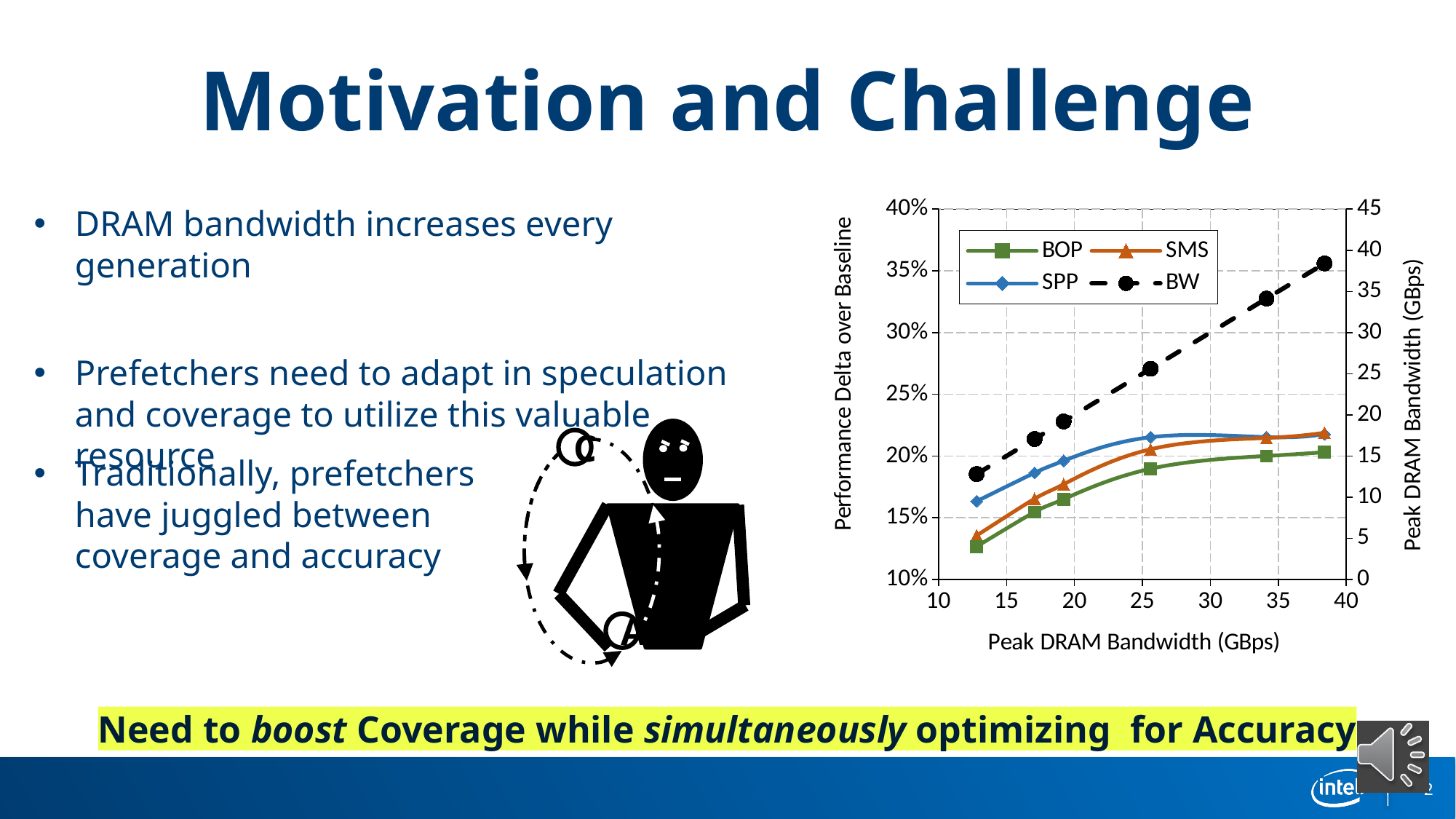
How many series does the chart legend list? 4 Which of the three prefetcher series (BOP, SMS, SPP) has the lowest Performance Delta over Baseline across the plotted range? BOP What kind of chart is shown on the slide? line chart How many data points are plotted for the BOP series? 6 Is the value for SMS at the highest plotted bandwidth greater or less than 20%? greater Which series are listed in the chart legend? BOP, SMS, SPP, BW What is the title of the chart's x axis? Peak DRAM Bandwidth (GBps) Is the value for SPP at the lowest plotted bandwidth greater or less than 15%? greater At the lowest plotted bandwidth, which is larger, the value for SPP or the value for BOP? SPP Does the BOP series rise or fall as Peak DRAM Bandwidth increases along the x axis? rise Does the BW series rise or fall as Peak DRAM Bandwidth increases along the x axis? rise Is the value for BOP at the lowest plotted bandwidth greater or less than 15%? less